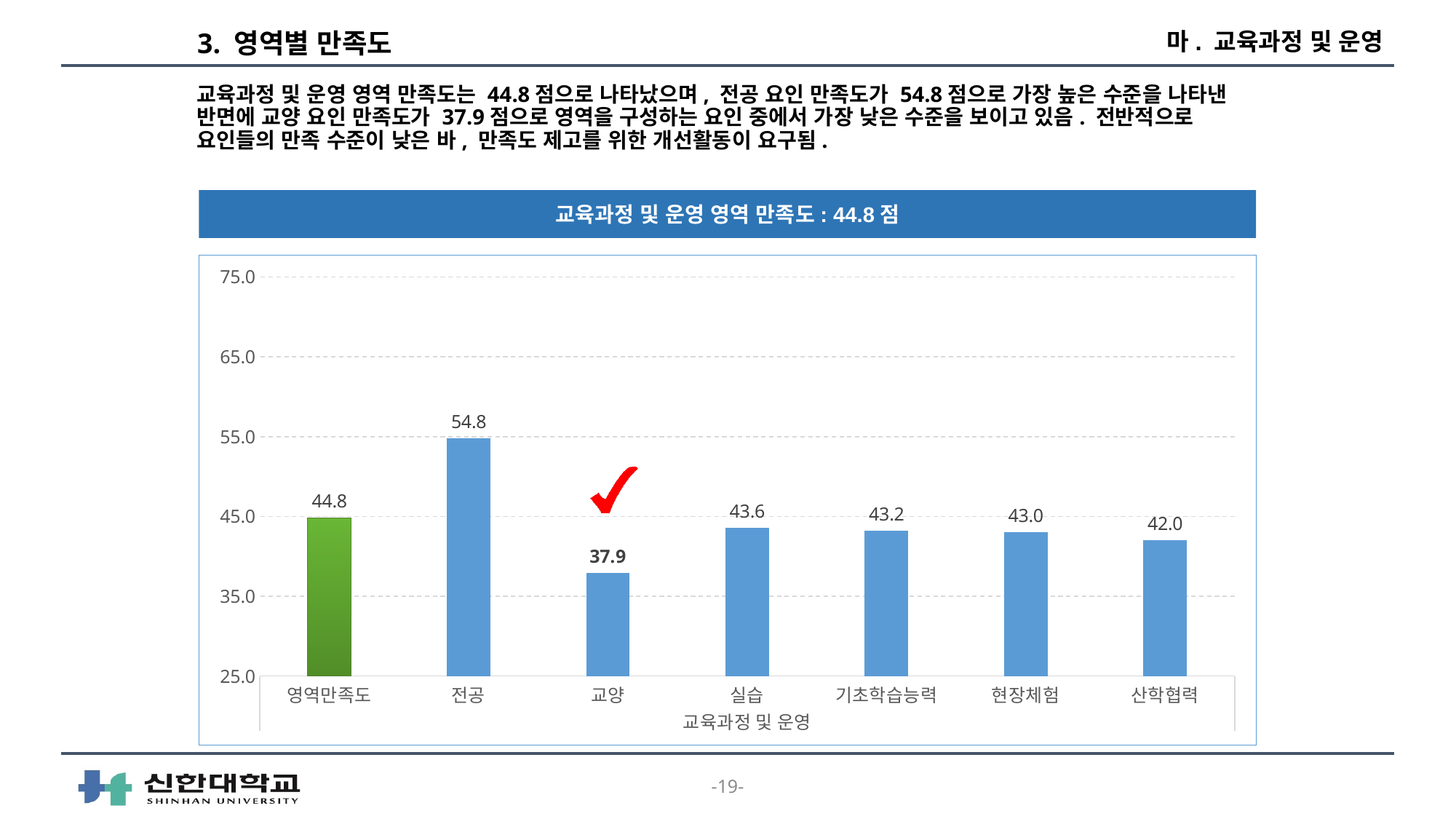
Which is larger, the value for 실습 or the value for 현장체험? 실습 What is the difference between the values for 전공 and 교양? 16.9 What is the value for 영역만족도? 44.8 What is the value for 산학협력? 42.0 Which category has the lowest value? 교양 Is the value for 기초학습능력 greater or less than 45.0? less How many categories are shown on the x axis? 7 Which category has the highest value? 전공 What is the value for 전공? 54.8 What is the value for 교양? 37.9 What is the x-axis title of the chart? 교육과정 및 운영 What kind of chart is shown? bar chart